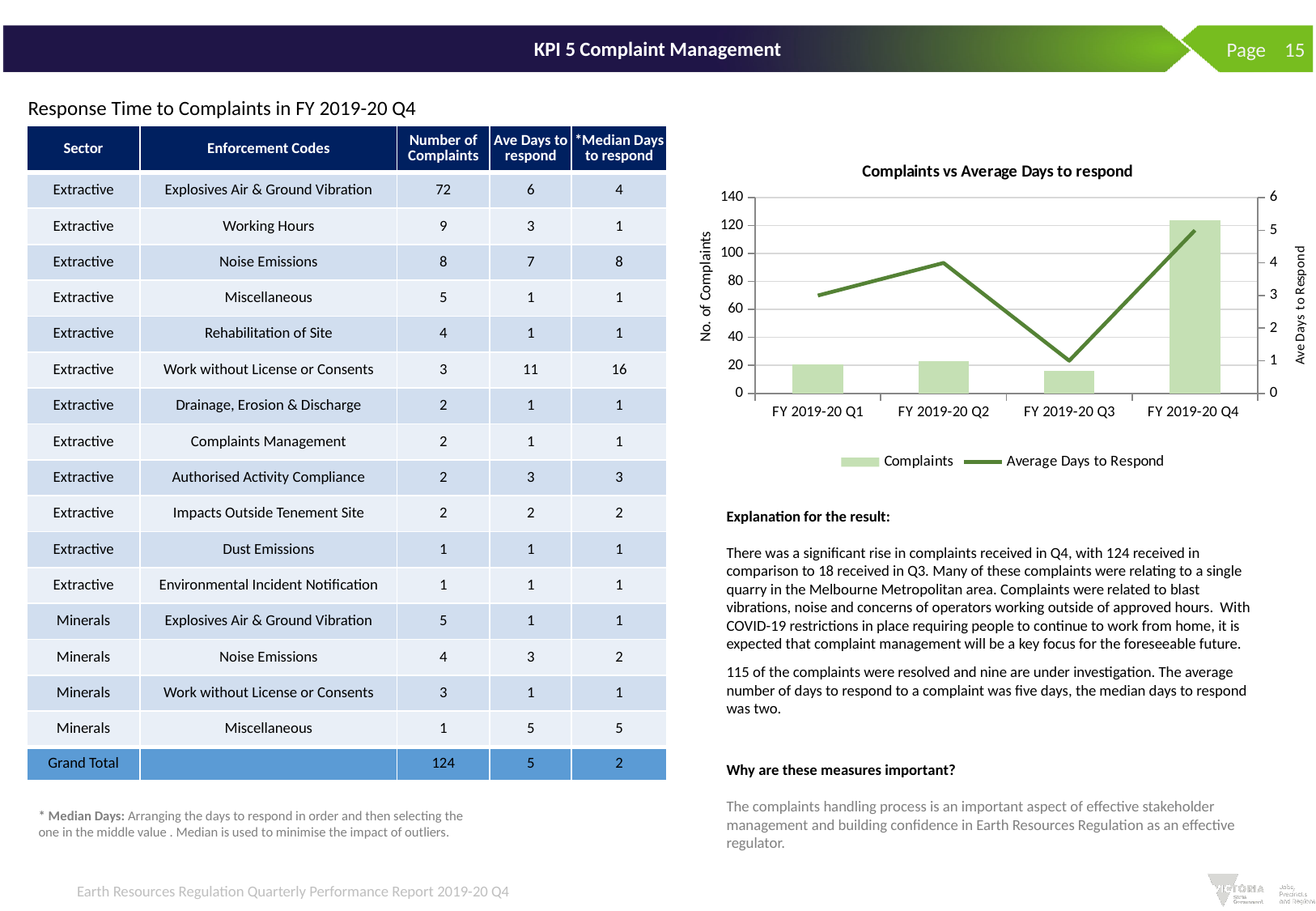
In the 'Complaints vs Average Days to respond' chart, which quarter has more complaints, FY 2019-20 Q1 or FY 2019-20 Q4? FY 2019-20 Q4 In the 'Complaints vs Average Days to respond' chart, is the number of complaints for FY 2019-20 Q4 greater or less than 100? greater What kind of chart is 'Complaints vs Average Days to respond'? bar and line chart In the 'Complaints vs Average Days to respond' chart, does the average days to respond rise or fall from FY 2019-20 Q3 to FY 2019-20 Q4? rise In the 'Complaints vs Average Days to respond' chart, which quarter has the highest number of complaints? FY 2019-20 Q4 How many series does the legend of the 'Complaints vs Average Days to respond' chart list? 2 How many quarters are shown on the x axis of the 'Complaints vs Average Days to respond' chart? 4 In the 'Complaints vs Average Days to respond' chart, is the average days to respond for FY 2019-20 Q2 greater or less than 3? greater In the 'Complaints vs Average Days to respond' chart, which quarter has the lowest average days to respond? FY 2019-20 Q3 In the 'Complaints vs Average Days to respond' chart, which quarter has the lowest number of complaints? FY 2019-20 Q3 In the 'Complaints vs Average Days to respond' chart, is the number of complaints for FY 2019-20 Q3 greater or less than 20? less What is the label of the right-hand vertical axis in the 'Complaints vs Average Days to respond' chart? Ave Days to Respond